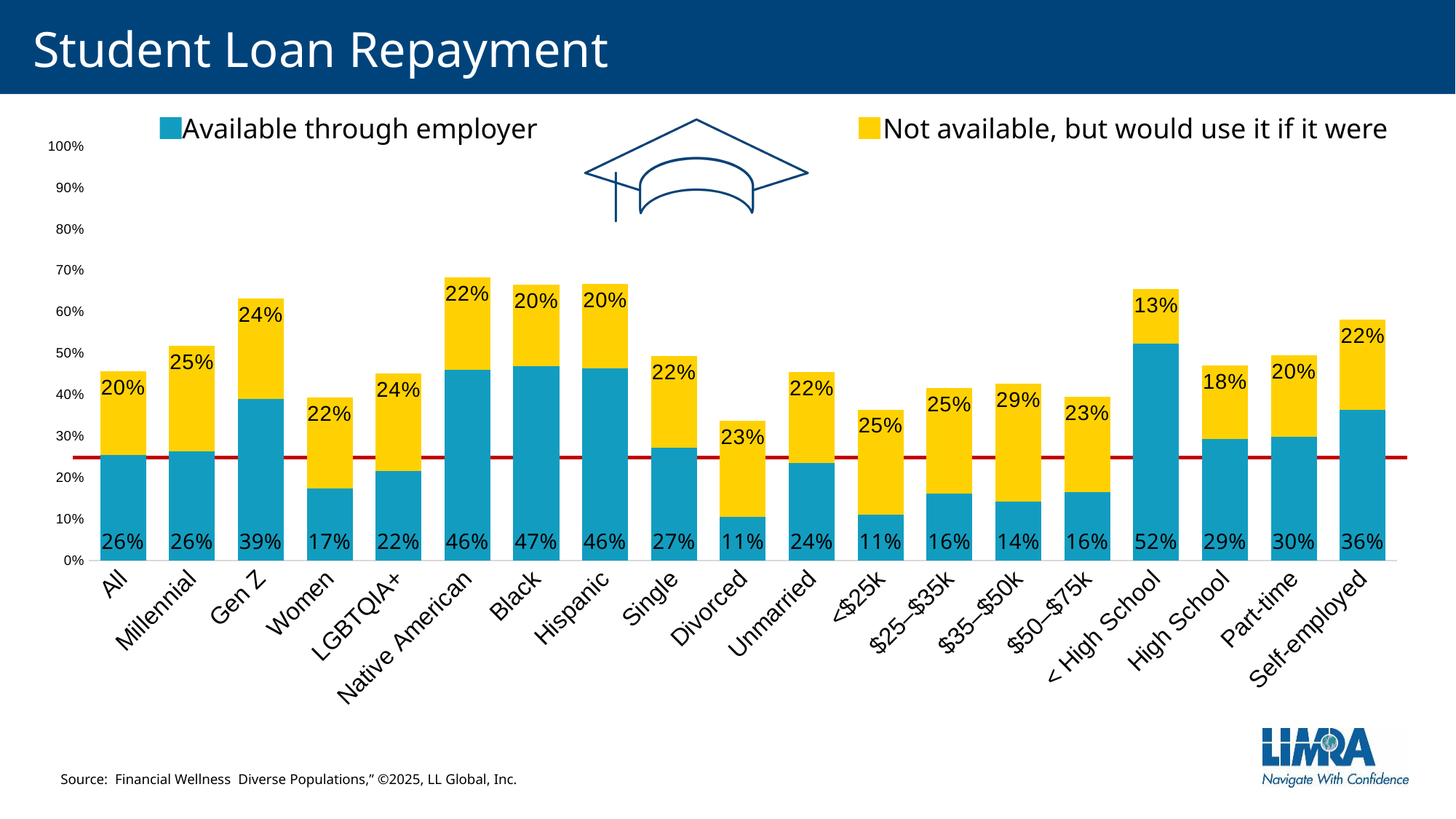
Which has a larger 'Available through employer' value, Self-employed or Part-time? Self-employed What percentage of Gen Z respondents have student loan repayment available through their employer? 39% Which colour represents the 'Available through employer' series? Blue What is the total height of the stacked bar for Native American? 68% How many series does the legend list? 2 What is the difference between the 'Available through employer' values for Black and Women? 30% How many categories are shown on the x axis? 19 What is the total height of the stacked bar for Divorced? 34% Which category has the lowest value for 'Not available, but would use it if it were'? < High School What is the value of the 'Not available, but would use it if it were' series for the $35–$50k group? 29% Which category has the highest value for 'Available through employer'? < High School What kind of chart is shown on the slide? Stacked bar chart